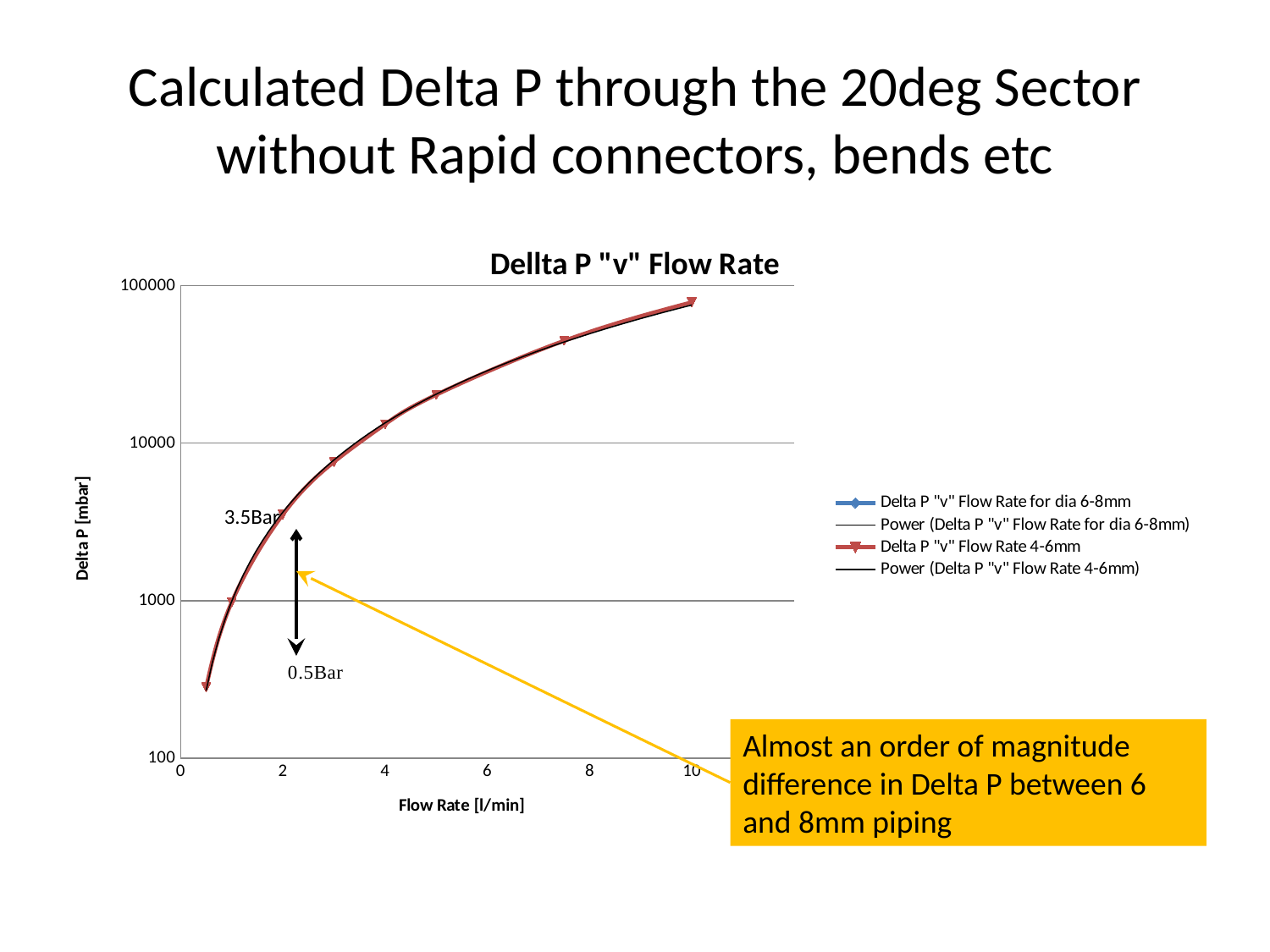
Which flow rate has the lowest Delta P value on the chart? 0.5 Which flow rate has the highest Delta P value on the chart? 10 How many series does the chart's legend list? 4 Is the Delta P value at a flow rate of 5 l/min greater or less than 100000? less Is the Delta P value at a flow rate of 0.5 l/min greater or less than 1000? less Is the Delta P value at a flow rate of 10 l/min greater or less than 10000? greater What is the title of the chart? Dellta P "v" Flow Rate What kind of chart is shown on the slide? line chart What is the label of the x axis of the chart? Flow Rate [l/min] Does Delta P rise or fall as Flow Rate increases along the x axis? rise